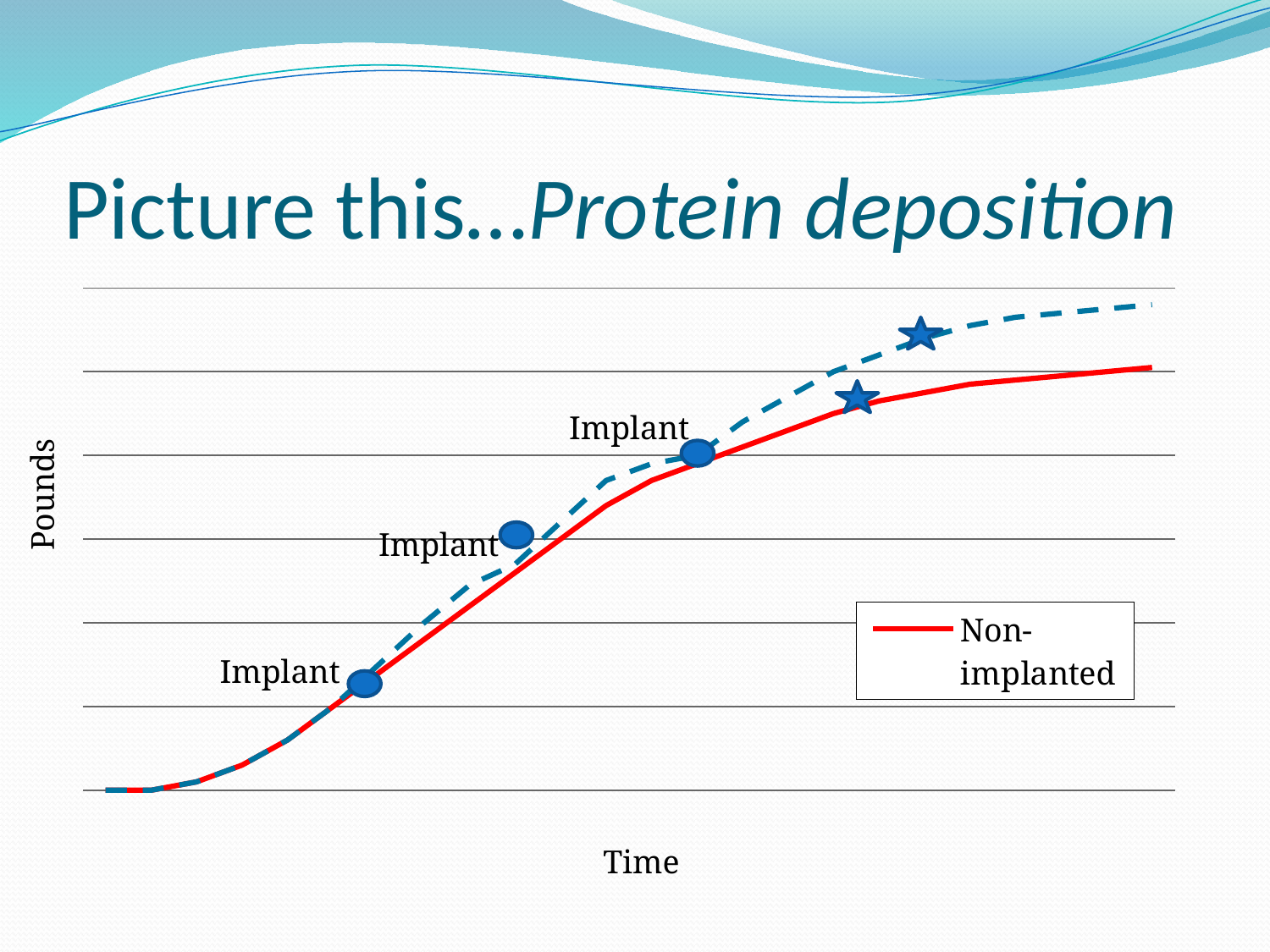
Which series is named in the chart's legend? Non-implanted Does the blue dashed line rise or fall along the x axis? rise What colour is the Non-implanted line in the chart? red How many series does the chart's legend list? 1 Do the values of the Non-implanted line rise or fall as time increases? rise What kind of chart is shown on the slide? line chart What is the label on the vertical axis of the chart? Pounds What is the label on the horizontal axis of the chart? Time How many points on the chart are labelled "Implant"? 3 At the right end of the chart, which line is higher: the red solid Non-implanted line or the blue dashed line? the blue dashed line